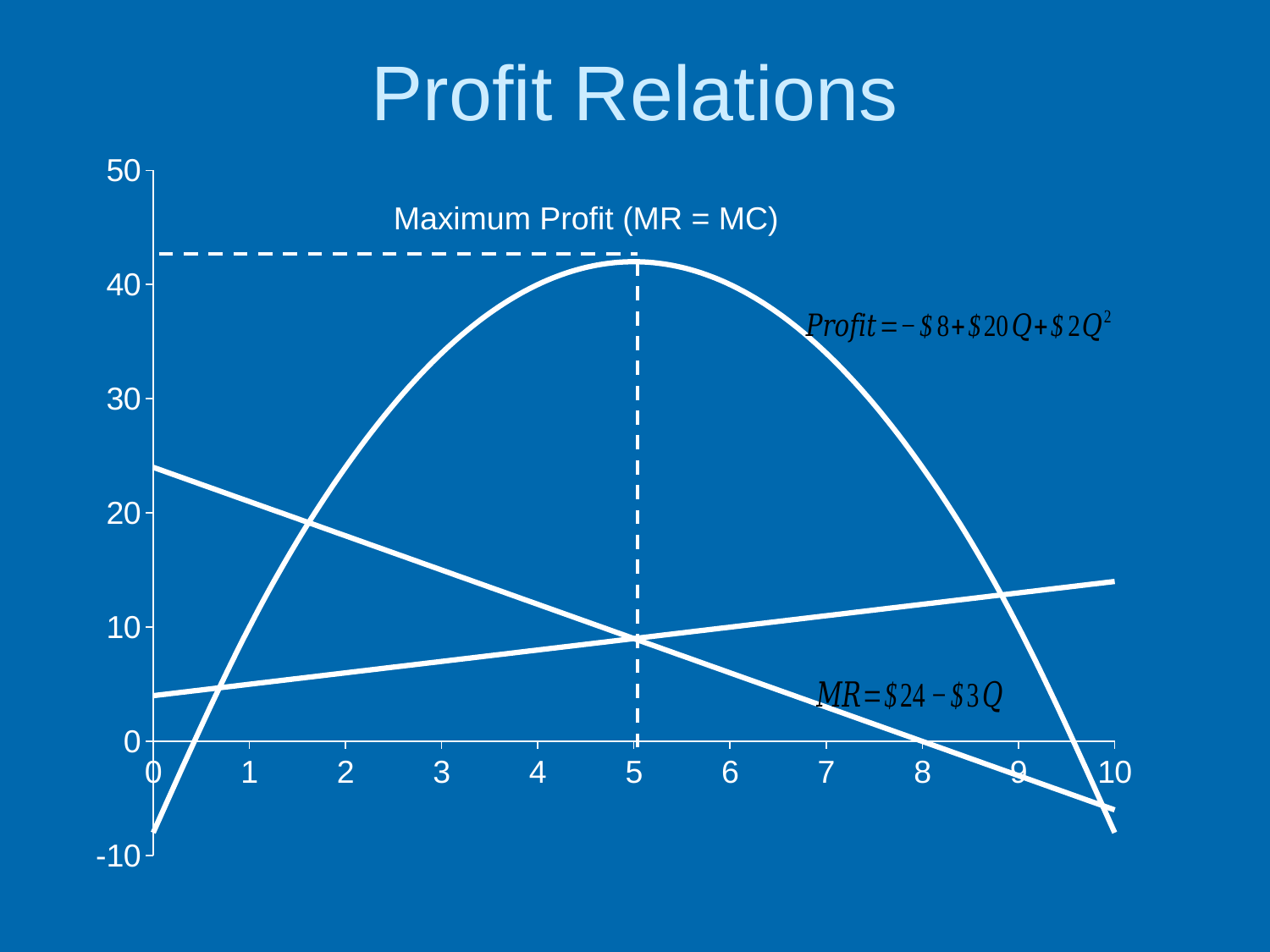
Does the MR line rise or fall as Q increases from 0 to 10? fall What equation is shown on the chart for MR? MR = $24 - $3Q What is the title of the chart on the slide? Profit Relations What kind of chart is shown on the slide? line chart How many lines are plotted on the chart? 3 Is the value of the Profit curve at Q = 3 greater or less than 30? greater Is the value of the Profit curve at Q = 5 greater or less than 40? greater Is the value of the Profit curve at Q = 0 greater or less than 0? less At what quantity does the dashed vertical line marking maximum profit meet the x axis? 5 At what quantity does the MR line cross the zero line on the y axis? 8